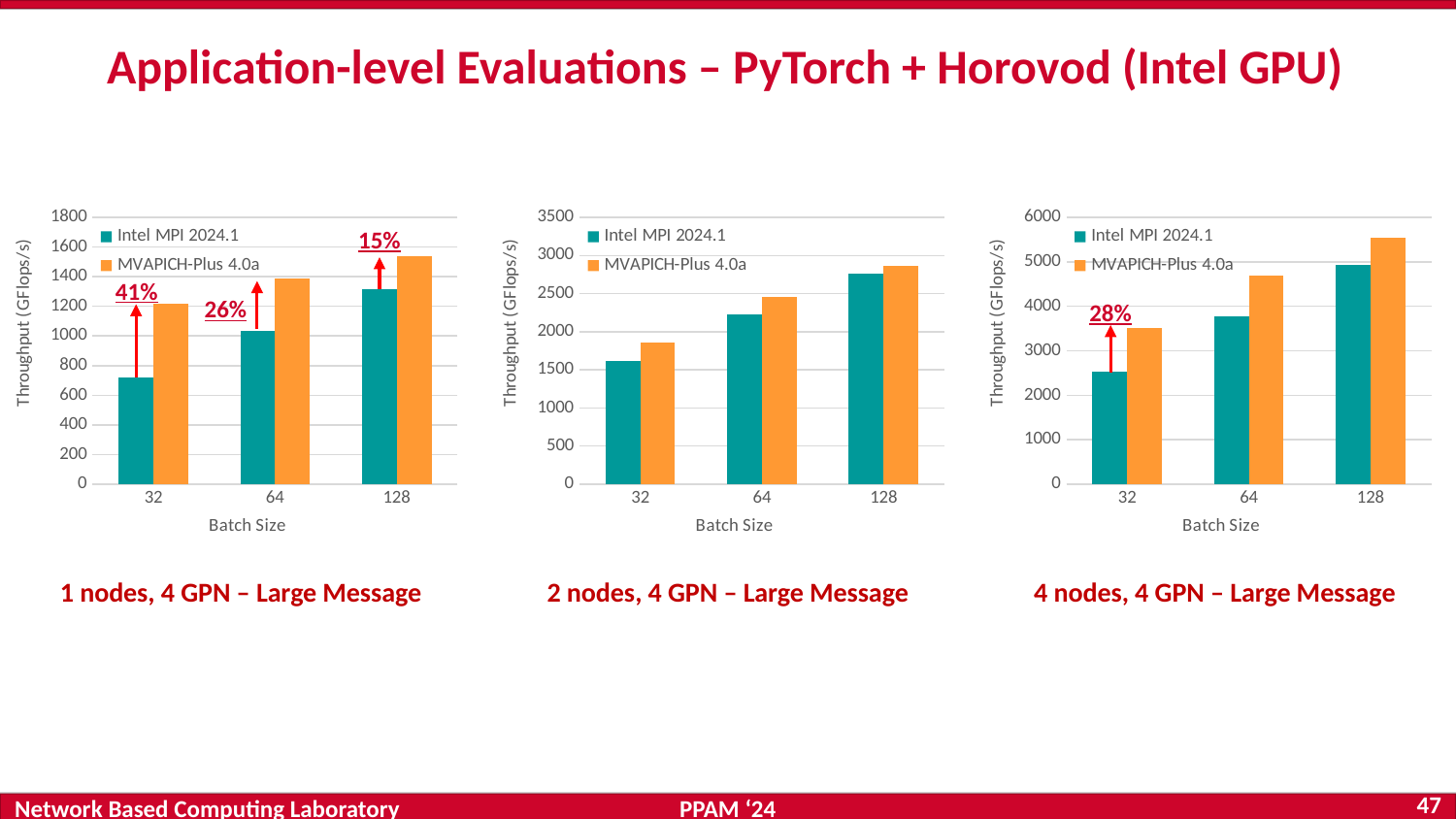
In the left chart ('1 nodes, 4 GPN – Large Message'), is the MVAPICH-Plus 4.0a value at batch size 128 greater or less than 1400? greater In the right chart ('4 nodes, 4 GPN – Large Message'), which series has the higher throughput at batch size 64, Intel MPI 2024.1 or MVAPICH-Plus 4.0a? MVAPICH-Plus 4.0a In the left chart ('1 nodes, 4 GPN – Large Message'), at which batch size is the Intel MPI 2024.1 throughput lowest? 32 In the right chart ('4 nodes, 4 GPN – Large Message'), does the Intel MPI 2024.1 throughput rise or fall as batch size increases? rise In the middle chart ('2 nodes, 4 GPN – Large Message'), is the Intel MPI 2024.1 value at batch size 32 greater or less than 1500? greater In the left chart ('1 nodes, 4 GPN – Large Message'), is the Intel MPI 2024.1 value at batch size 32 greater or less than 800? less In the right chart ('4 nodes, 4 GPN – Large Message'), how many batch sizes are shown on the x axis? 3 In the middle chart ('2 nodes, 4 GPN – Large Message'), how many series does the legend list? 2 In the middle chart ('2 nodes, 4 GPN – Large Message'), at which batch size is the MVAPICH-Plus 4.0a throughput highest? 128 In the left chart ('1 nodes, 4 GPN – Large Message'), what percentage improvement is annotated at batch size 64? 26% What kind of chart is the left chart titled '1 nodes, 4 GPN – Large Message'? bar chart